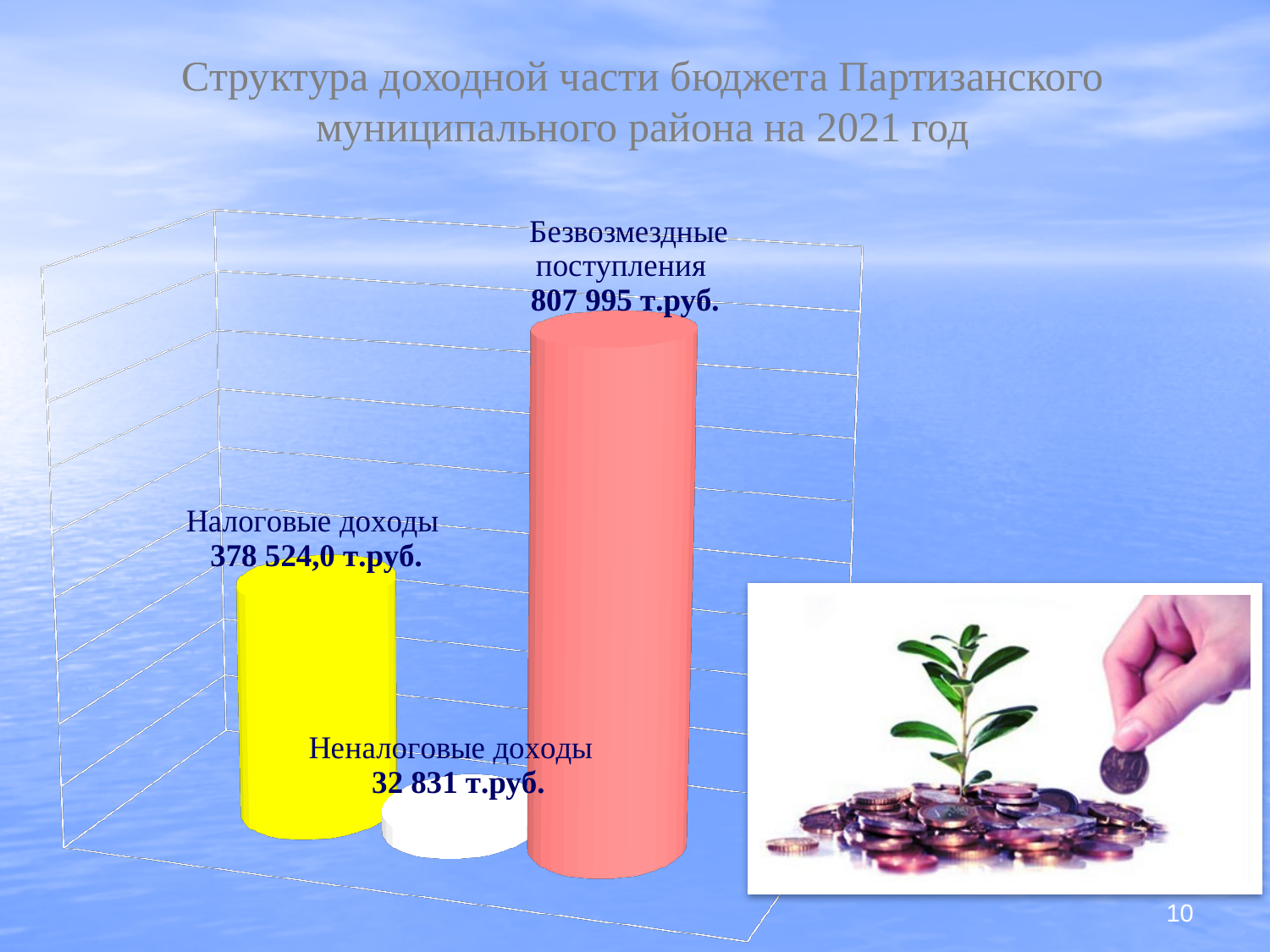
Which is larger, Безвозмездные поступления or Налоговые доходы? Безвозмездные поступления How many categories are shown in the chart? 3 What is the value for Неналоговые доходы? 32 831 т.руб. What kind of chart is shown on the slide? Bar chart Which category has the highest value? Безвозмездные поступления Which is larger, Налоговые доходы or Неналоговые доходы? Налоговые доходы What colour is the bar for Налоговые доходы? Yellow What is the value for Безвозмездные поступления? 807 995 т.руб. Which category has the lowest value? Неналоговые доходы What is the value for Налоговые доходы? 378 524,0 т.руб. What is the difference between Безвозмездные поступления and Налоговые доходы? 429 471,0 т.руб. What is the difference between Налоговые доходы and Неналоговые доходы? 345 693,0 т.руб.